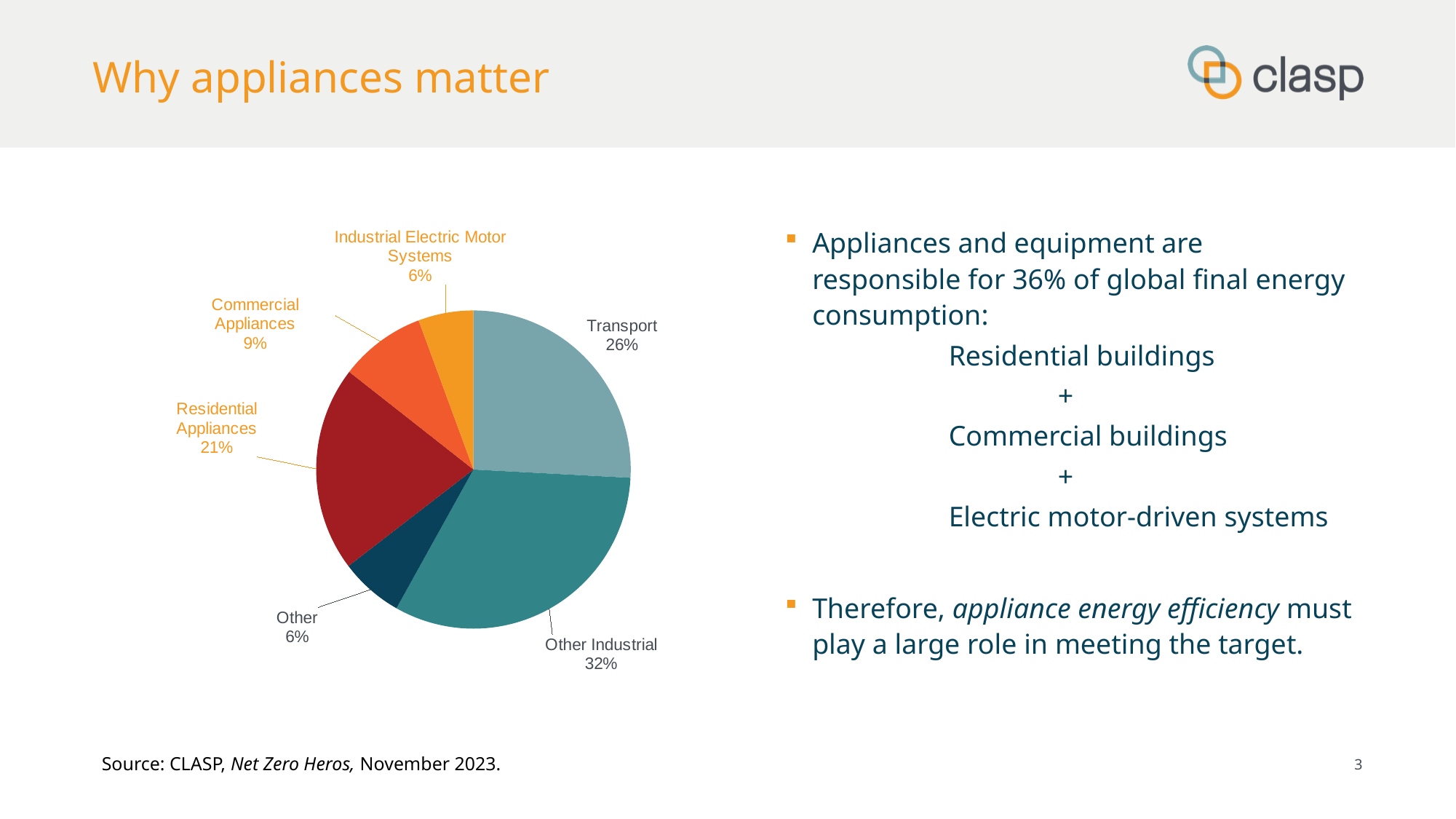
What is the difference between the Residential Appliances and Other shares? 15% What is the difference between the Other Industrial and Transport shares? 6% What is the value shown for Industrial Electric Motor Systems? 6% What is the value shown for Residential Appliances? 21% What share of the pie does Transport account for? 26% What is the value shown for Commercial Appliances? 9% Which categories in the pie chart are labelled in orange text? Industrial Electric Motor Systems, Commercial Appliances, Residential Appliances What kind of chart is shown on the slide? Pie chart Which category has the largest slice of the pie? Other Industrial Which is larger, Residential Appliances or Commercial Appliances? Residential Appliances What is the combined share of Residential Appliances, Commercial Appliances and Industrial Electric Motor Systems? 36% How many slices does the pie chart have? 6